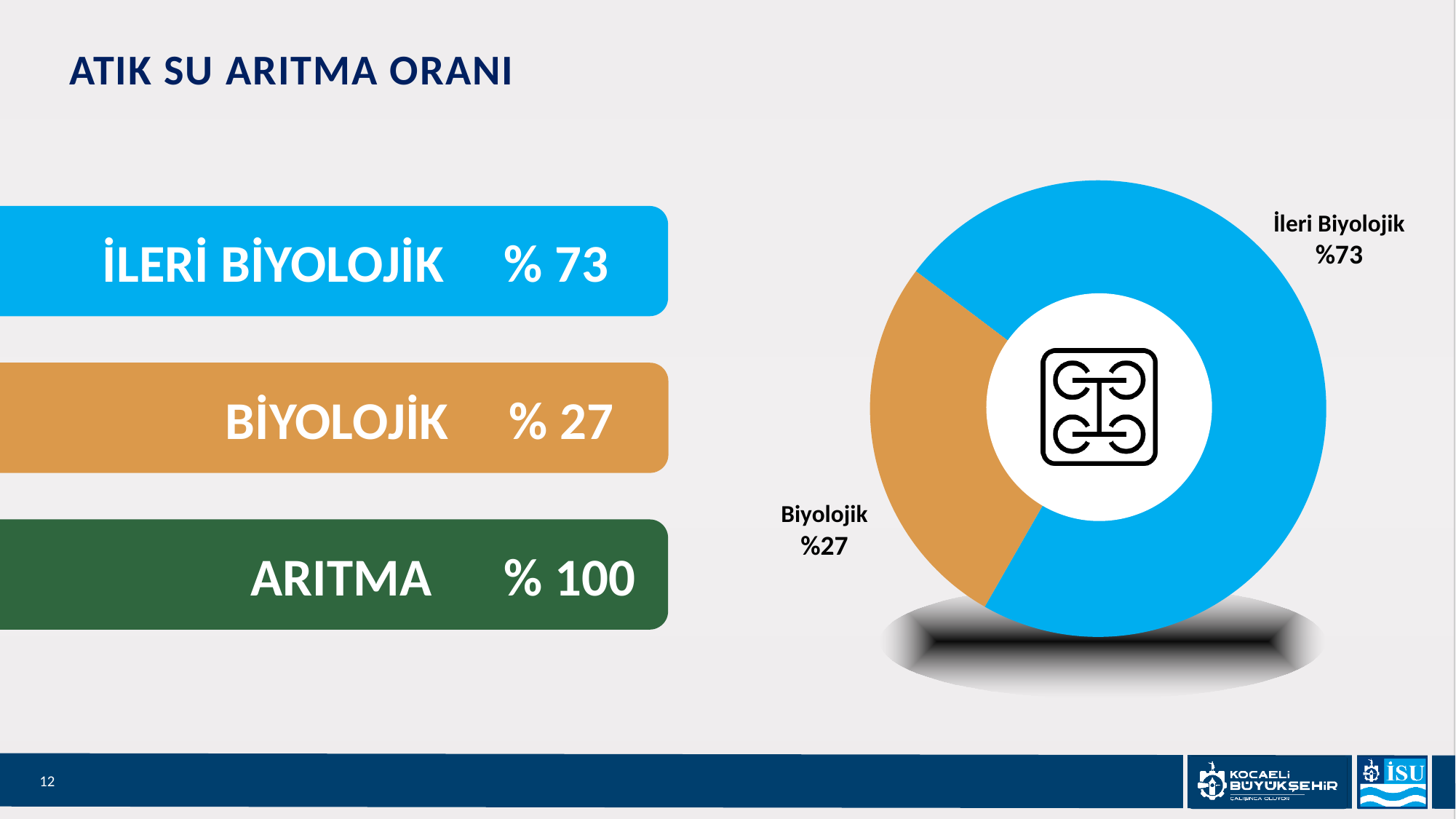
Which slice of the chart is the largest? İleri Biyolojik What is the difference between the İleri Biyolojik and Biyolojik values? 46 What is the total of the two slices in the chart? 100 What colour is the İleri Biyolojik slice? Blue What is the value for İleri Biyolojik in the chart? %73 What is the value for Biyolojik in the chart? %27 What share of the chart does the Biyolojik slice represent? %27 Which slice of the chart is the smallest? Biyolojik Which is larger, İleri Biyolojik or Biyolojik? İleri Biyolojik How many slices does the chart have? 2 What is the title of the slide containing the chart? ATIK SU ARITMA ORANI What kind of chart is shown on the slide? Doughnut chart